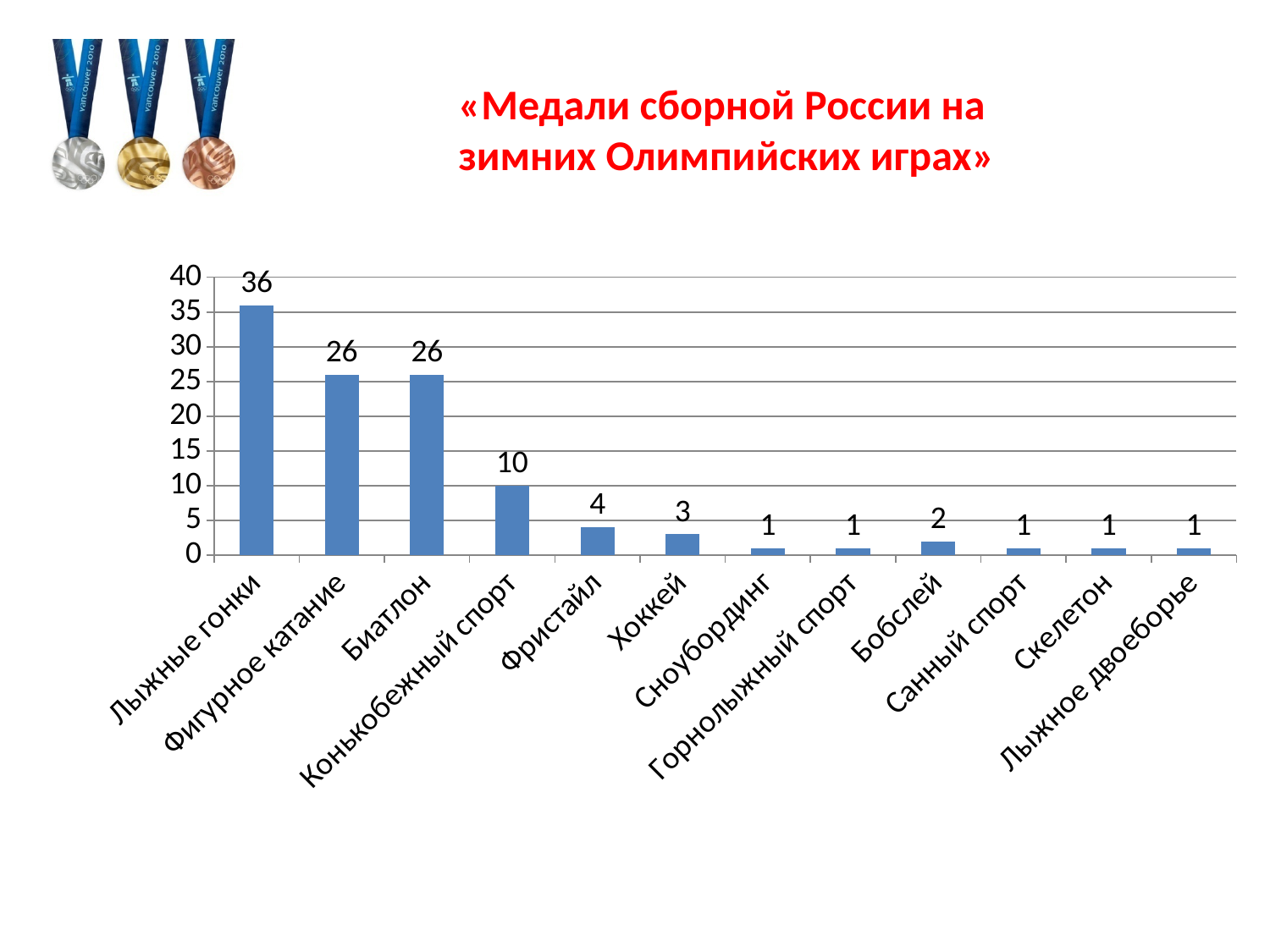
How many categories are shown on the x axis? 12 What is the difference between the values for Конькобежный спорт and Фристайл? 6 How many medals does the chart show for Лыжные гонки? 36 What is the difference between the values for Лыжные гонки and Биатлон? 10 What kind of chart is shown on the slide? bar chart Is the value for Фигурное катание greater or less than 20? greater Which is larger, the value for Фристайл or the value for Хоккей? Фристайл What is the value for Хоккей? 3 What is the title of the slide? «Медали сборной России на зимних Олимпийских играх» What is the value for Бобслей? 2 Which category has the highest value? Лыжные гонки What is the value for Конькобежный спорт? 10